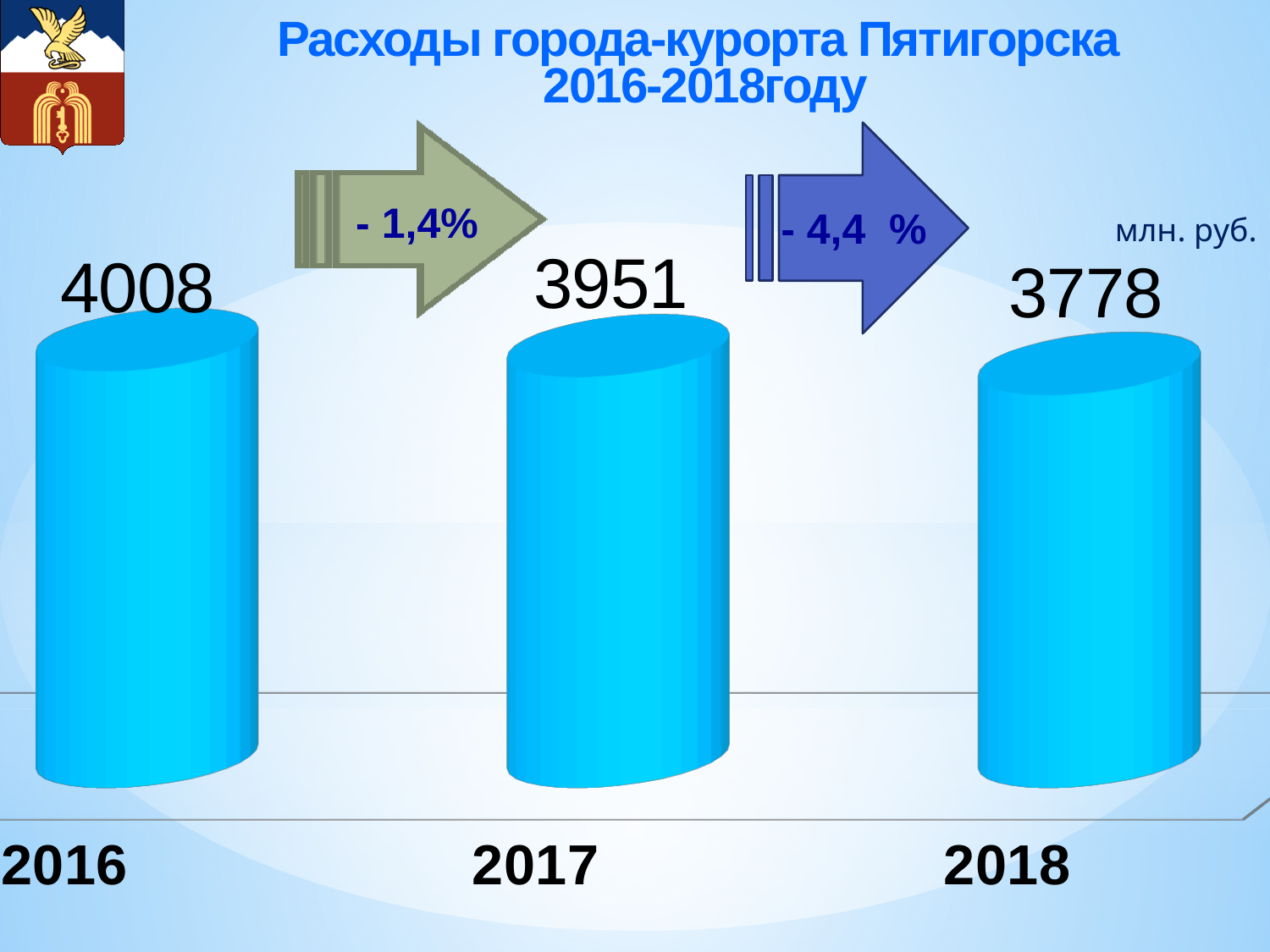
What unit is shown on the chart? млн. руб. What kind of chart is this? bar chart How many years are shown on the chart? 3 Which year has the highest value? 2016 Which is larger, the value for 2016 or the value for 2017? 2016 What is the value for 2016? 4008 What is the difference between the values for 2017 and 2018? 173 What is the difference between the values for 2016 and 2018? 230 What is the value for 2018? 3778 Do the values rise or fall from 2016 to 2018? fall What is the value for 2017? 3951 Which year has the lowest value? 2018